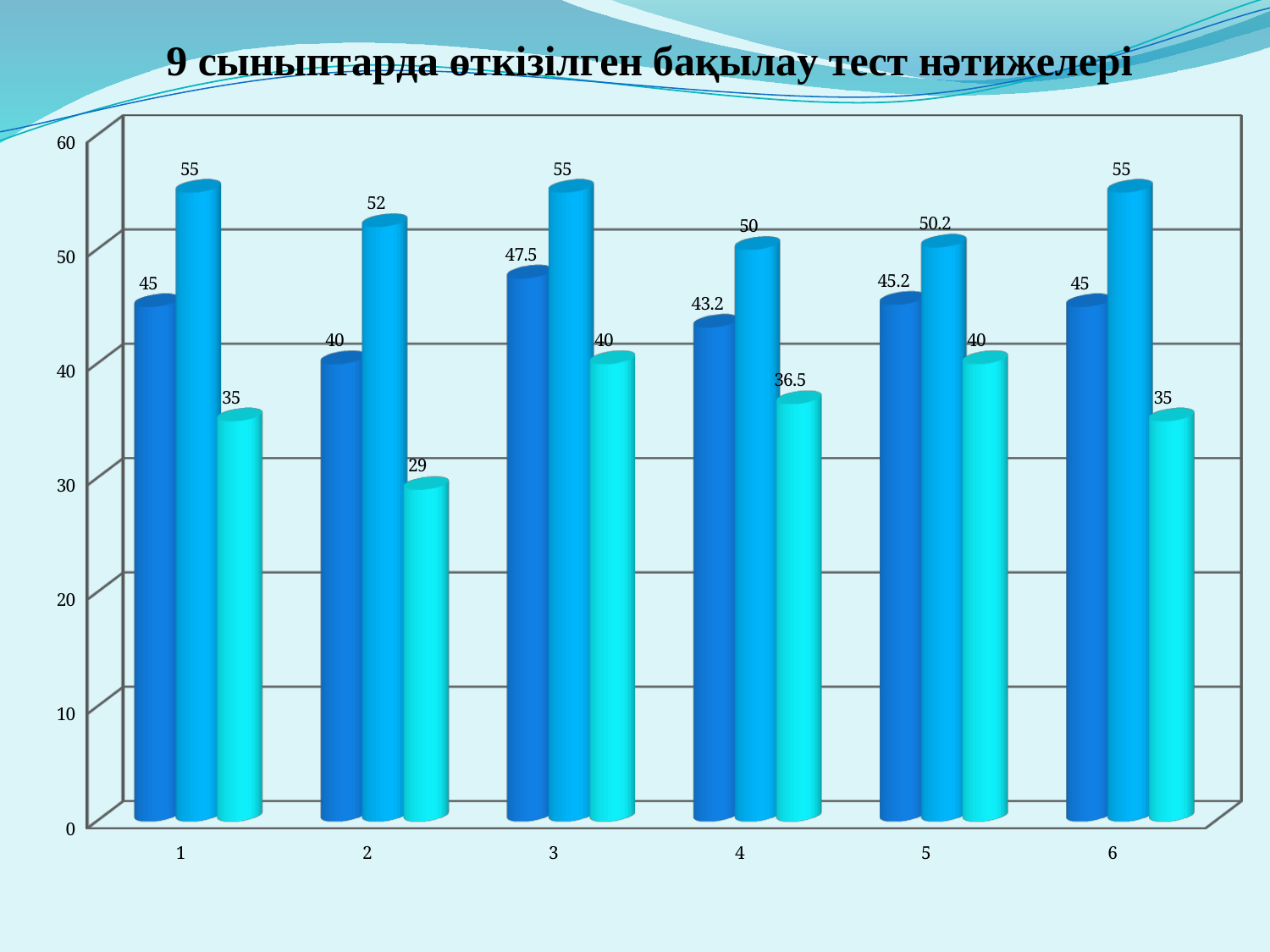
What is the value of the dark blue (first) bar for category 3? 47.5 How many categories are shown on the x axis? 6 What is the difference between the dark blue (first) bar for category 3 and the dark blue bar for category 4? 4.3 What is the title of the chart? 9 сыныптарда өткізілген бақылау тест нәтижелері Which is larger for category 5: the dark blue (first) bar or the light cyan (third) bar? the dark blue (first) bar Which category has the lowest value for the light cyan (third) bar? 2 What kind of chart is shown on the slide? bar chart What is the difference between the medium blue (second) bar and the light cyan (third) bar for category 2? 23 What is the value of the light cyan (third) bar for category 4? 36.5 What is the value of the light cyan (third) bar for category 2? 29 Which category has the highest value for the dark blue (first) bar? 3 What is the value of the medium blue (second) bar for category 5? 50.2